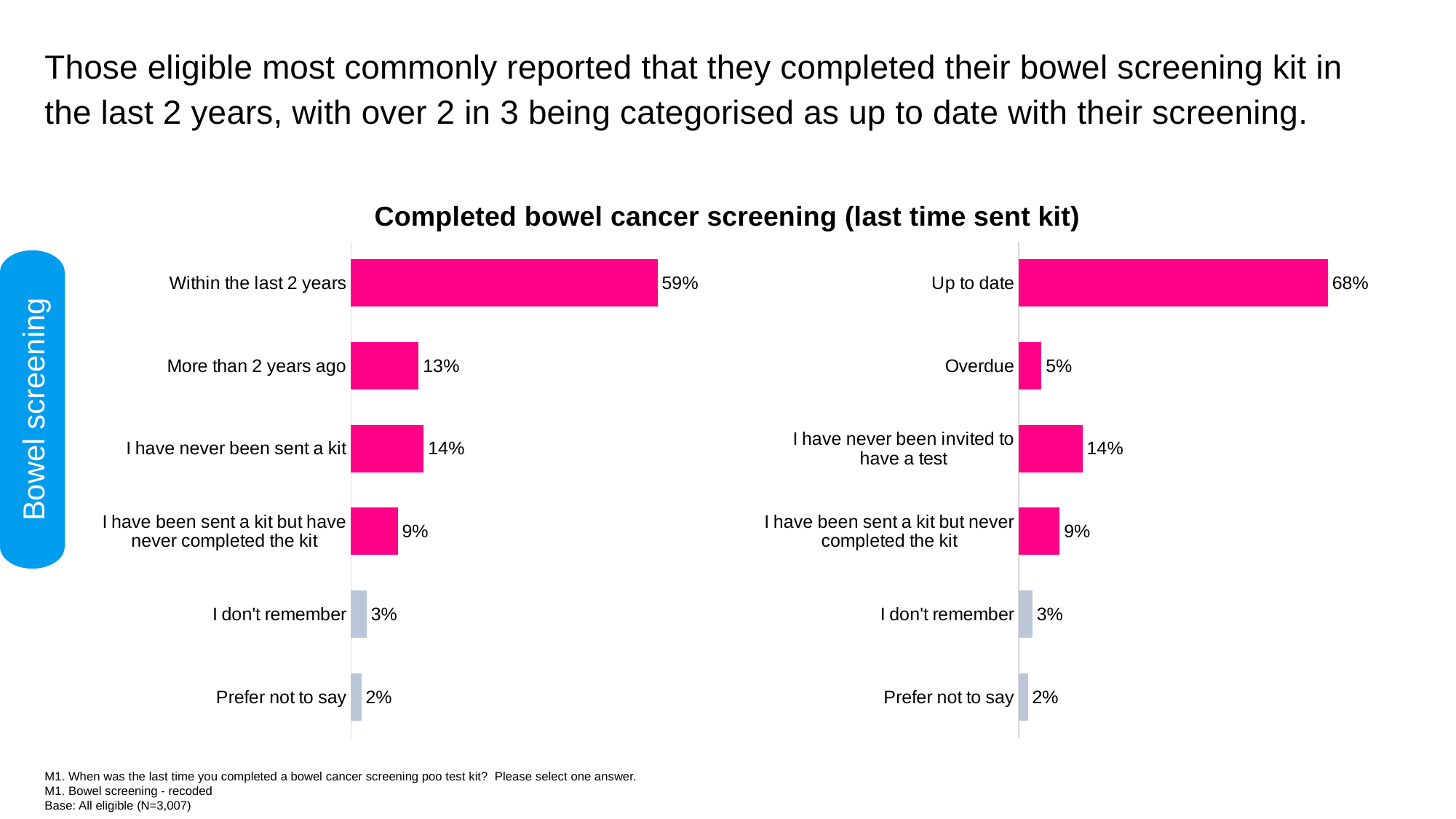
In the left chart, which is larger: 'More than 2 years ago' or 'I have been sent a kit but have never completed the kit'? More than 2 years ago In the right chart, what is the value for 'Overdue'? 5% In the left chart, what is the difference between 'Within the last 2 years' and 'More than 2 years ago'? 46 percentage points What type of chart is used on this slide? Bar chart In the right chart, what is the difference between 'Up to date' and 'Overdue'? 63 percentage points In the right chart, which category has the lowest value? Prefer not to say In the left chart, which category has the highest value? Within the last 2 years In the left chart, what is the value for 'I have never been sent a kit'? 14% In the right chart, what percentage are categorised as up to date? 68% In the left chart, what percentage reported completing their kit within the last 2 years? 59% What is the title shown above the charts? Completed bowel cancer screening (last time sent kit) How many categories are shown in the right chart? 6